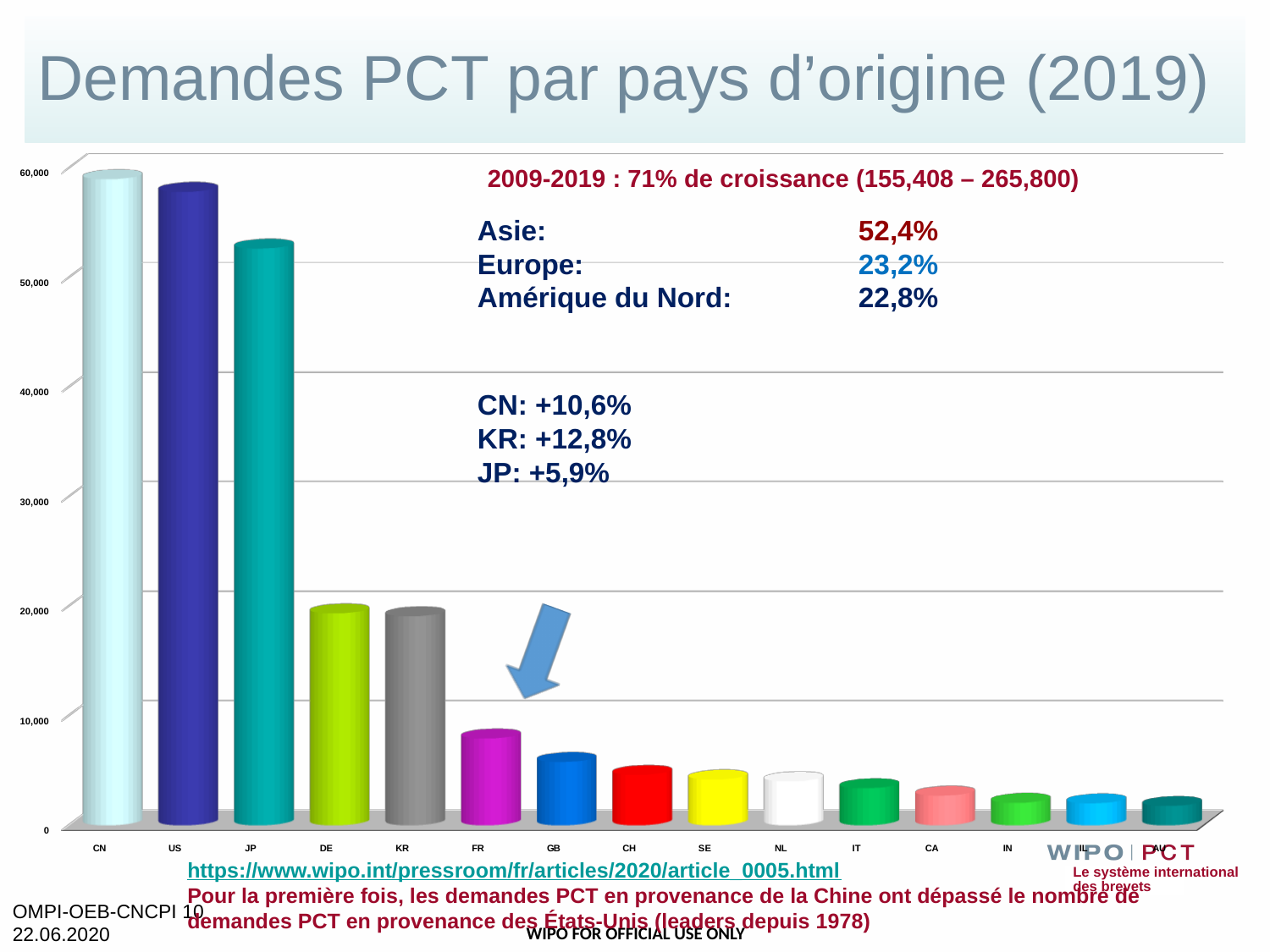
Which is larger, the value for FR or the value for GB? FR How many countries are shown on the x axis of the chart? 15 What is the title of the slide containing the chart? Demandes PCT par pays d’origine (2019) Do the values rise or fall moving from left to right along the x axis? fall Is the value for CN greater or less than 50,000? greater What kind of chart is shown on the slide? bar chart Which country has the highest number of PCT applications in the chart? CN Which is larger, the value for JP or the value for DE? JP Is the value for FR greater or less than 10,000? less Is the value for JP greater or less than 50,000? greater